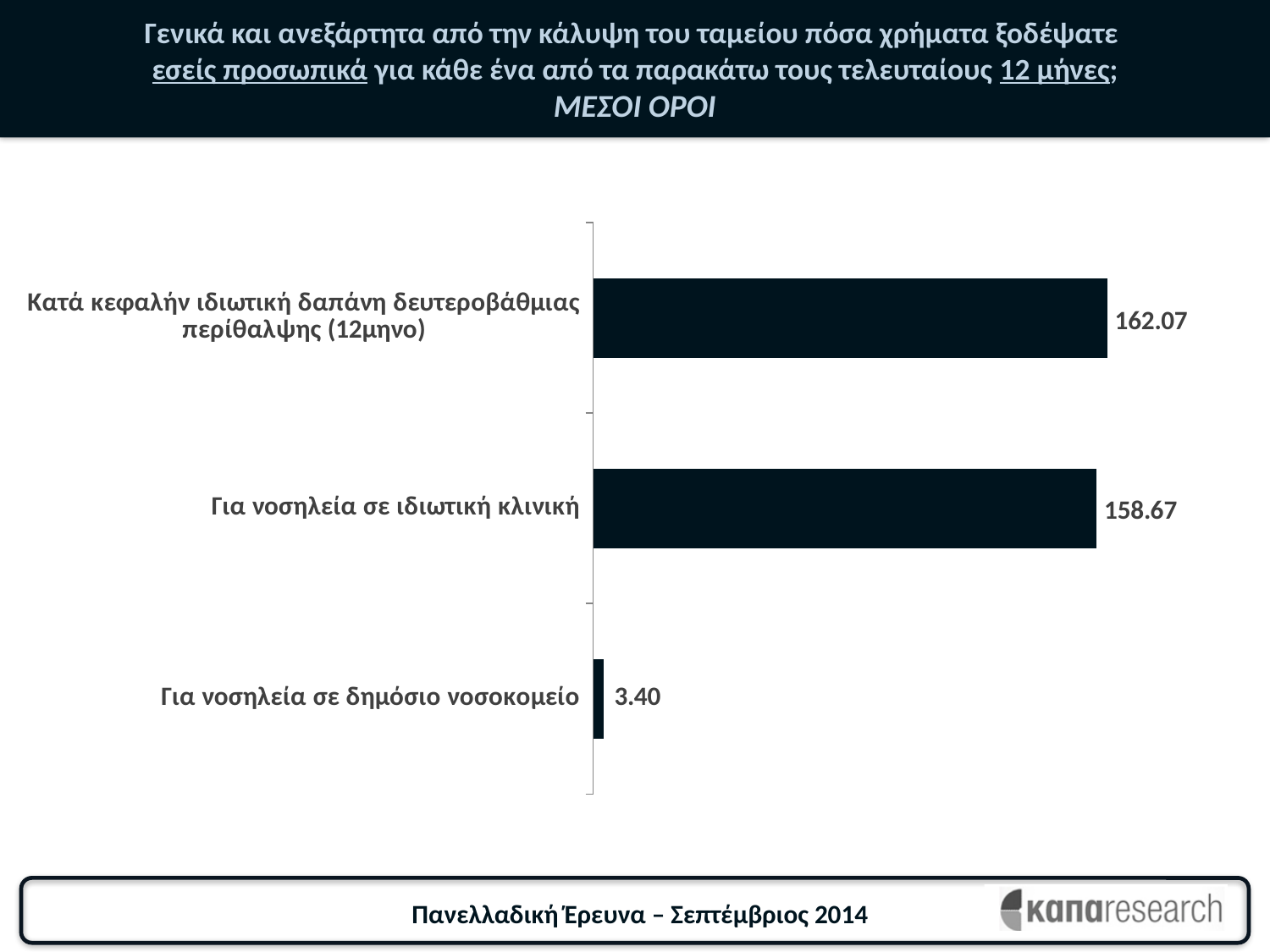
What is the value for 'Για νοσηλεία σε ιδιωτική κλινική'? 158.67 What is the total of the three values shown in the chart? 324.14 Which is larger: the value for 'Για νοσηλεία σε ιδιωτική κλινική' or the value for 'Για νοσηλεία σε δημόσιο νοσοκομείο'? Για νοσηλεία σε ιδιωτική κλινική What is the difference between the values for 'Κατά κεφαλήν ιδιωτική δαπάνη δευτεροβάθμιας περίθαλψης (12μηνο)' and 'Για νοσηλεία σε ιδιωτική κλινική'? 3.40 What is the value for 'Για νοσηλεία σε δημόσιο νοσοκομείο'? 3.40 Which category has the lowest value? Για νοσηλεία σε δημόσιο νοσοκομείο What is the value for 'Κατά κεφαλήν ιδιωτική δαπάνη δευτεροβάθμιας περίθαλψης (12μηνο)'? 162.07 How many categories are shown in the chart? 3 What is the difference between the values for 'Για νοσηλεία σε ιδιωτική κλινική' and 'Για νοσηλεία σε δημόσιο νοσοκομείο'? 155.27 Which category has the highest value? Κατά κεφαλήν ιδιωτική δαπάνη δευτεροβάθμιας περίθαλψης (12μηνο) What colour are the bars in the chart? Black What kind of chart is shown on the slide? Bar chart